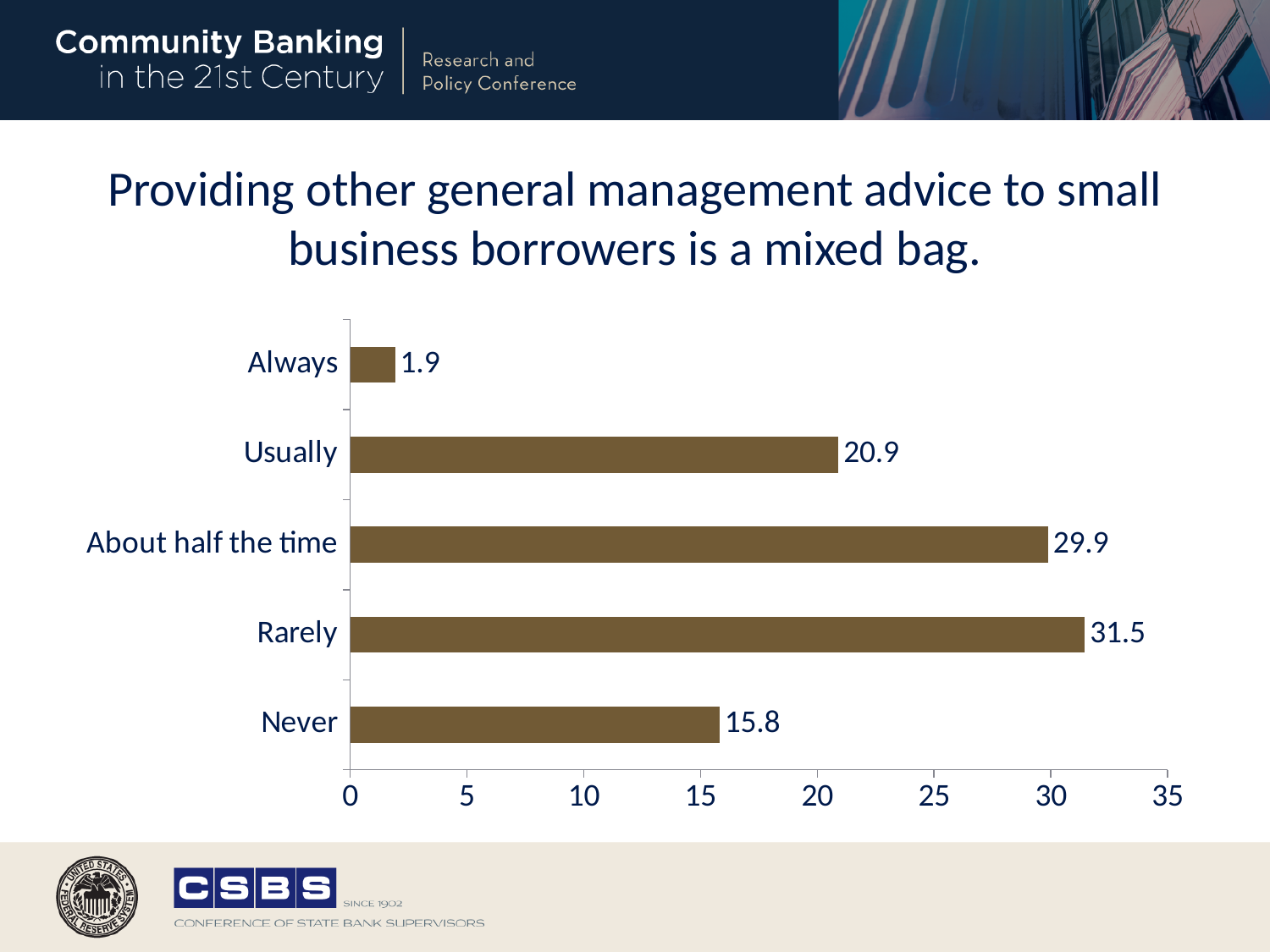
Which is larger, the value for "Usually" or the value for "Never"? Usually What kind of chart is shown on the slide? Bar chart Which category has the highest value? Rarely Is the value for "About half the time" greater or less than 25? greater What is the value for "About half the time"? 29.9 What is the value for "Rarely"? 31.5 What is the difference between the values for "Usually" and "Never"? 5.1 What is the value for "Always"? 1.9 Which category has the lowest value? Always What is the maximum value shown on the horizontal axis? 35 How many categories are shown in the chart? 5 What is the value for "Never"? 15.8